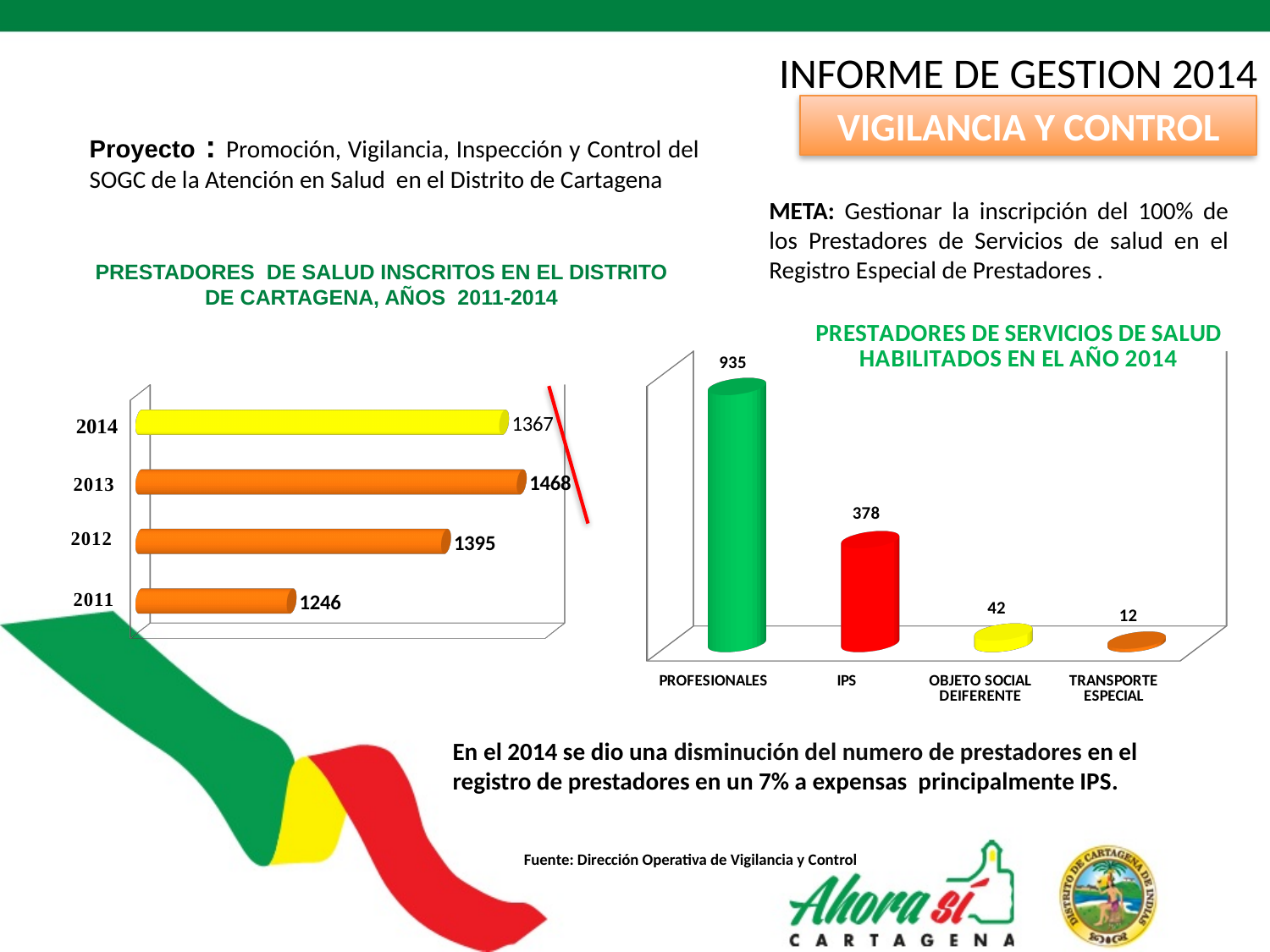
In the chart 'PRESTADORES DE SALUD INSCRITOS EN EL DISTRITO DE CARTAGENA, AÑOS 2011-2014', what is the difference between the values for 2013 and 2014? 101 In the chart 'PRESTADORES DE SALUD INSCRITOS EN EL DISTRITO DE CARTAGENA, AÑOS 2011-2014', which year has the lowest value? 2011 In the chart 'PRESTADORES DE SERVICIOS DE SALUD HABILITADOS EN EL AÑO 2014', which category has the highest value? PROFESIONALES In the chart 'PRESTADORES DE SALUD INSCRITOS EN EL DISTRITO DE CARTAGENA, AÑOS 2011-2014', which year has the highest value? 2013 In the chart 'PRESTADORES DE SALUD INSCRITOS EN EL DISTRITO DE CARTAGENA, AÑOS 2011-2014', what is the value for 2013? 1468 In the chart 'PRESTADORES DE SERVICIOS DE SALUD HABILITADOS EN EL AÑO 2014', what is the difference between PROFESIONALES and IPS? 557 What kind of chart is 'PRESTADORES DE SALUD INSCRITOS EN EL DISTRITO DE CARTAGENA, AÑOS 2011-2014'? Bar chart In the chart 'PRESTADORES DE SERVICIOS DE SALUD HABILITADOS EN EL AÑO 2014', which is larger, OBJETO SOCIAL DEIFERENTE or TRANSPORTE ESPECIAL? OBJETO SOCIAL DEIFERENTE In the chart 'PRESTADORES DE SERVICIOS DE SALUD HABILITADOS EN EL AÑO 2014', what is the value for IPS? 378 In the chart 'PRESTADORES DE SALUD INSCRITOS EN EL DISTRITO DE CARTAGENA, AÑOS 2011-2014', what is the value for 2011? 1246 In the chart 'PRESTADORES DE SERVICIOS DE SALUD HABILITADOS EN EL AÑO 2014', what is the value for TRANSPORTE ESPECIAL? 12 In the chart 'PRESTADORES DE SALUD INSCRITOS EN EL DISTRITO DE CARTAGENA, AÑOS 2011-2014', how many years are shown? 4